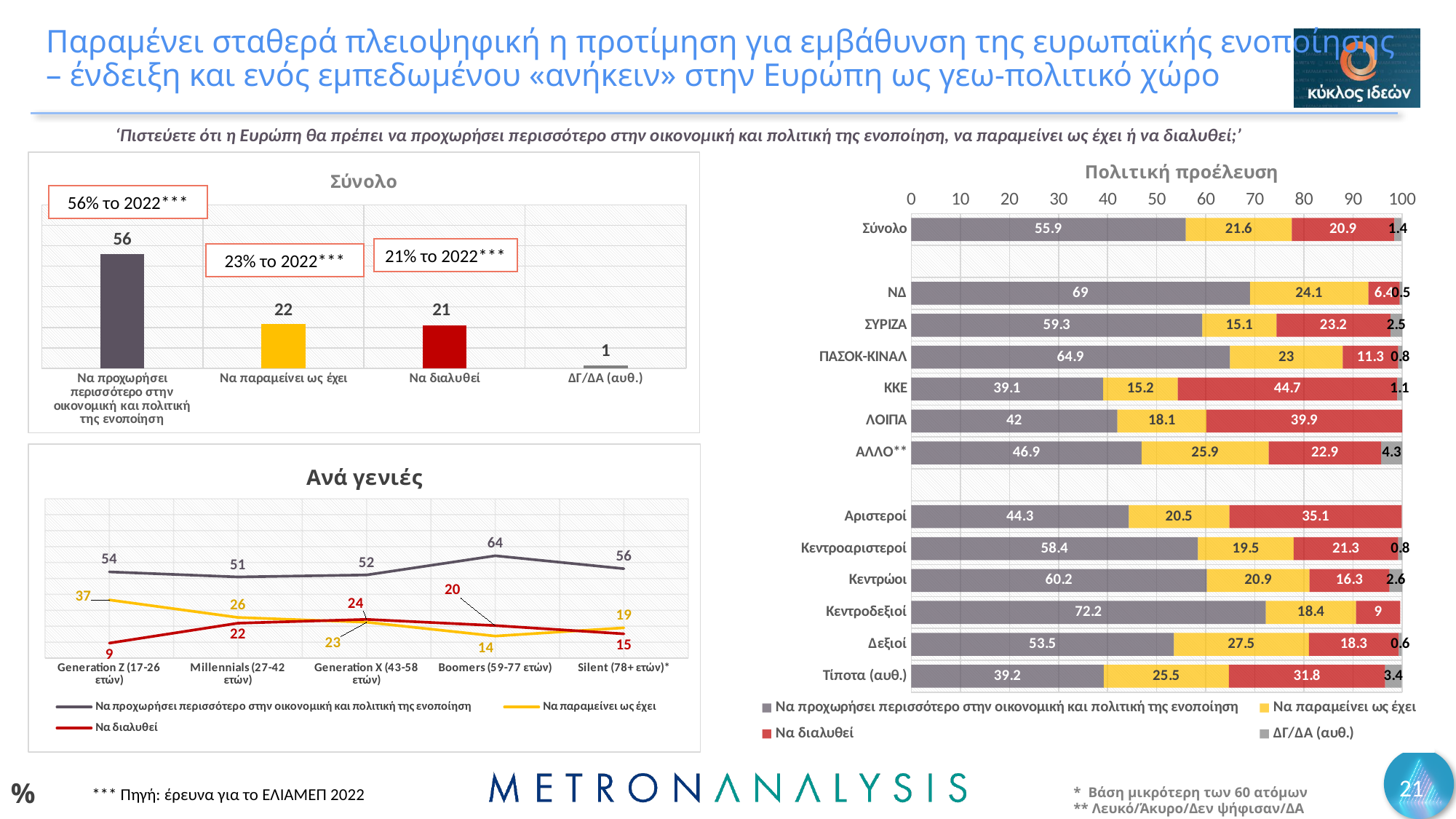
In the 'Ανά γενιές' chart, what is the value for Boomers (59-77 ετών) in the series 'Να προχωρήσει περισσότερο στην οικονομική και πολιτική της ενοποίηση'? 64 In the 'Σύνολο' chart, which category has the highest value? Να προχωρήσει περισσότερο στην οικονομική και πολιτική της ενοποίηση In the 'Πολιτική προέλευση' chart, which category has the highest value for 'Να προχωρήσει περισσότερο στην οικονομική και πολιτική της ενοποίηση'? Κεντροδεξιοί In the 'Πολιτική προέλευση' chart, which has the larger value for 'Να προχωρήσει περισσότερο στην οικονομική και πολιτική της ενοποίηση', ΝΔ or ΣΥΡΙΖΑ? ΝΔ How many series does the legend of the 'Ανά γενιές' chart list? 3 In the 'Σύνολο' chart, what is the value for 'Να παραμείνει ως έχει'? 22 In the 'Πολιτική προέλευση' chart, what is the value for ΚΚΕ in the series 'Να διαλυθεί'? 44.7 How many categories are shown in the 'Πολιτική προέλευση' chart? 13 What kind of chart is the 'Σύνολο' chart? bar chart What kind of chart is the 'Ανά γενιές' chart? line chart How many categories are shown in the 'Σύνολο' chart? 4 In the 'Ανά γενιές' chart, what is the difference between 'Να παραμείνει ως έχει' and 'Να διαλυθεί' for Generation Z (17-26 ετών)? 28